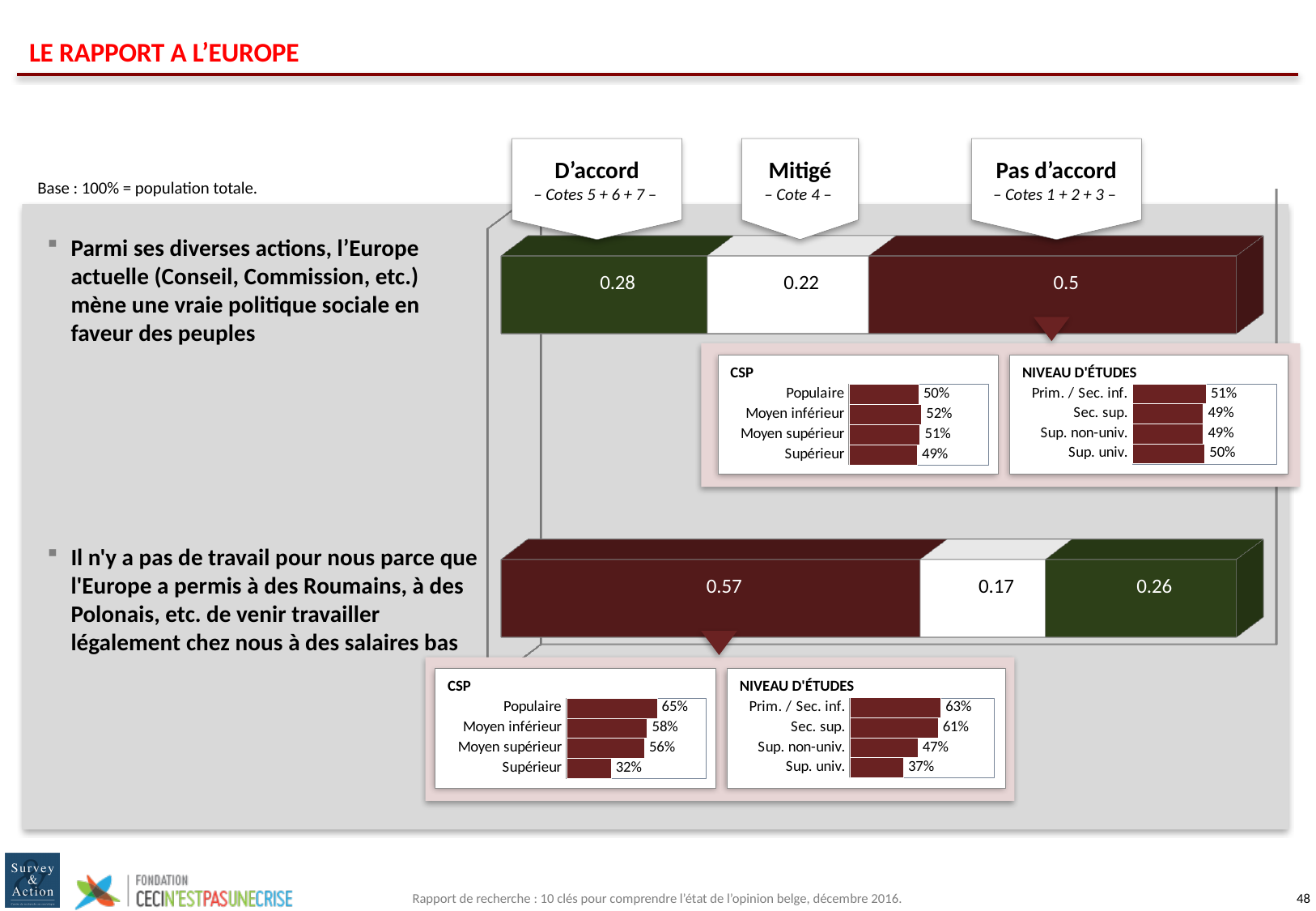
In the top stacked bar (statement about Europe's social policy), what is the value for 'D'accord'? 0.28 In the upper CSP chart (below the top stacked bar), what is the value for 'Moyen inférieur'? 52% In the bottom stacked bar, which is larger: the dark red segment (0.57) or the green segment (0.26)? the dark red segment (0.57) How many categories are shown in the upper NIVEAU D'ÉTUDES chart (below the top stacked bar)? 4 In the bottom stacked bar (statement about Romanians and Poles coming to work), what is the value of the 'Mitigé' (white) segment? 0.17 In the lower CSP chart (below the bottom stacked bar), which category has the highest value? Populaire In the lower CSP chart (below the bottom stacked bar), what is the value for 'Supérieur'? 32% In the lower NIVEAU D'ÉTUDES chart, what is the difference between 'Prim. / Sec. inf.' and 'Sup. non-univ.'? 16% In the bottom stacked bar (statement about Romanians and Poles coming to work), what is the value of the dark red 'Pas d'accord' segment? 0.57 In the top stacked bar, what is the difference between the 'Pas d'accord' value and the 'D'accord' value? 0.22 In the lower NIVEAU D'ÉTUDES chart (below the bottom stacked bar), which category has the lowest value? Sup. univ. In the top stacked bar (statement about Europe's social policy), what is the value for 'Pas d'accord'? 0.5